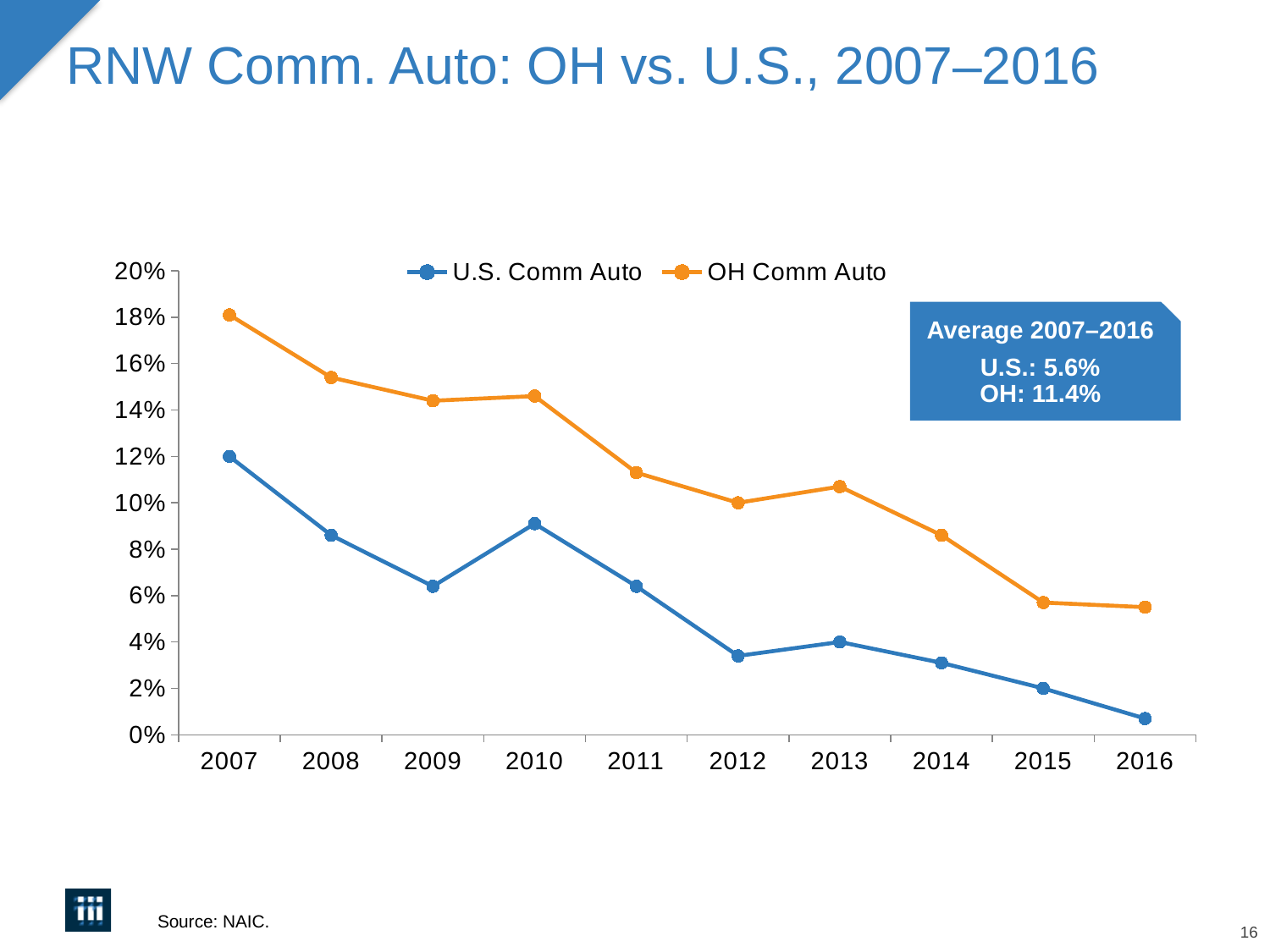
In which year is the OH Comm Auto value highest? 2007 How many series does the legend list? 2 Is the U.S. Comm Auto value for 2012 greater or less than 4%? less In 2010, which series has the larger value, U.S. Comm Auto or OH Comm Auto? OH Comm Auto Is the OH Comm Auto value for 2007 greater or less than 16%? greater Do the OH Comm Auto values generally rise or fall from 2007 to 2016? fall Is the U.S. Comm Auto value for 2016 greater or less than 2%? less According to the text box on the chart, what is the U.S. average for 2007–2016? 5.6% How many years are plotted along the x axis? 10 According to the text box on the chart, what is the OH average for 2007–2016? 11.4% In which year is the U.S. Comm Auto value lowest? 2016 What kind of chart is shown on the slide? line chart